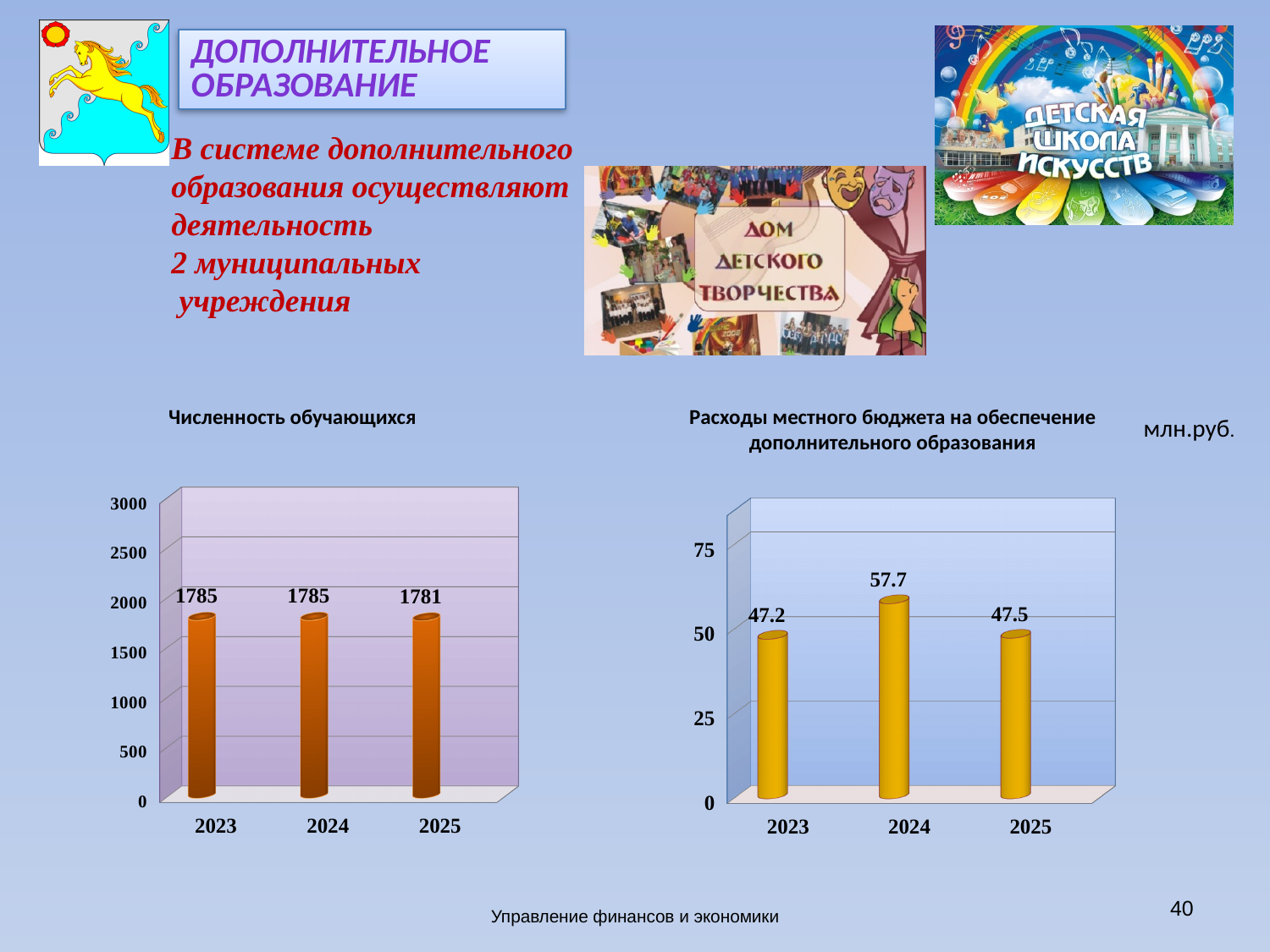
In the chart 'Расходы местного бюджета на обеспечение дополнительного образования', what is the value for 2024? 57.7 In the chart 'Расходы местного бюджета на обеспечение дополнительного образования', what is the difference between the values for 2024 and 2023? 10.5 In the chart 'Расходы местного бюджета на обеспечение дополнительного образования', which year has the highest value? 2024 What kind of chart is the chart 'Расходы местного бюджета на обеспечение дополнительного образования'? bar chart In the chart 'Численность обучающихся', how many years are shown on the x axis? 3 In the chart 'Численность обучающихся', what is the value for 2023? 1785 In the chart 'Численность обучающихся', is the value for 2024 greater or less than 2000? less In the chart 'Численность обучающихся', what is the value for 2025? 1781 In the chart 'Численность обучающихся', what is the difference between the values for 2024 and 2025? 4 In the chart 'Расходы местного бюджета на обеспечение дополнительного образования', which year has the lowest value? 2023 In the chart 'Численность обучающихся', which year has the lowest value? 2025 In the chart 'Расходы местного бюджета на обеспечение дополнительного образования', what is the value for 2023? 47.2